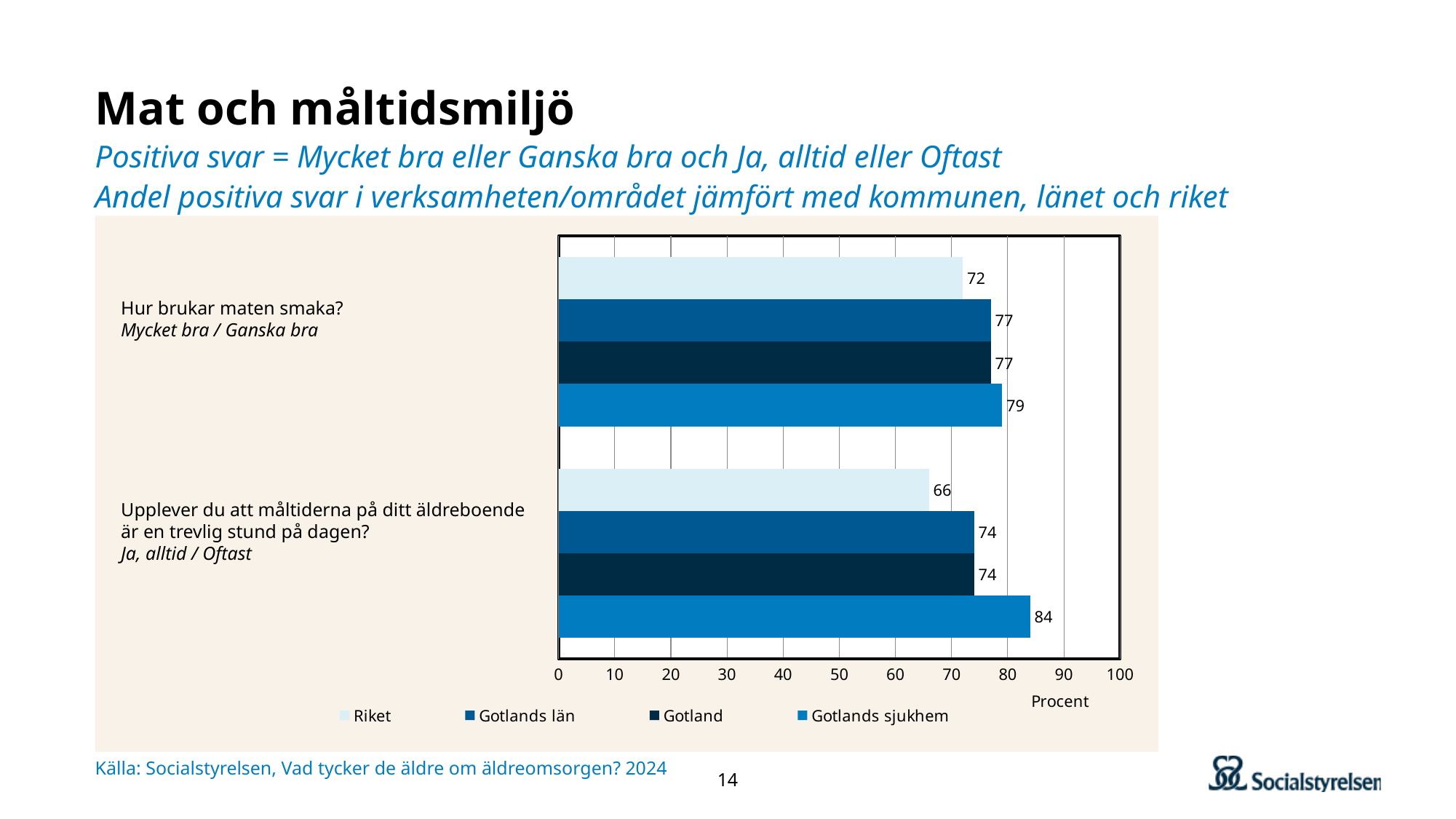
How many question categories are shown on the chart? 2 What is the value for Gotlands sjukhem for the question "Hur brukar maten smaka?"? 79 What is the label on the horizontal axis of the chart? Procent How many series does the legend list? 4 What kind of chart is shown on the slide? Bar chart Which series has the lowest value for the question "Hur brukar maten smaka?"? Riket What is the value for Gotlands län for the question "Hur brukar maten smaka?"? 77 Which is larger: the Riket value for "Hur brukar maten smaka?" or the Riket value for "Upplever du att måltiderna på ditt äldreboende är en trevlig stund på dagen?"? Hur brukar maten smaka? Which series has the highest value for the question "Upplever du att måltiderna på ditt äldreboende är en trevlig stund på dagen?"? Gotlands sjukhem What is the difference between Gotlands sjukhem and Gotland for the question "Hur brukar maten smaka?"? 2 What is the difference between Gotlands sjukhem and Riket for the question "Upplever du att måltiderna på ditt äldreboende är en trevlig stund på dagen?"? 18 What is the value for Riket for the question "Upplever du att måltiderna på ditt äldreboende är en trevlig stund på dagen?"? 66